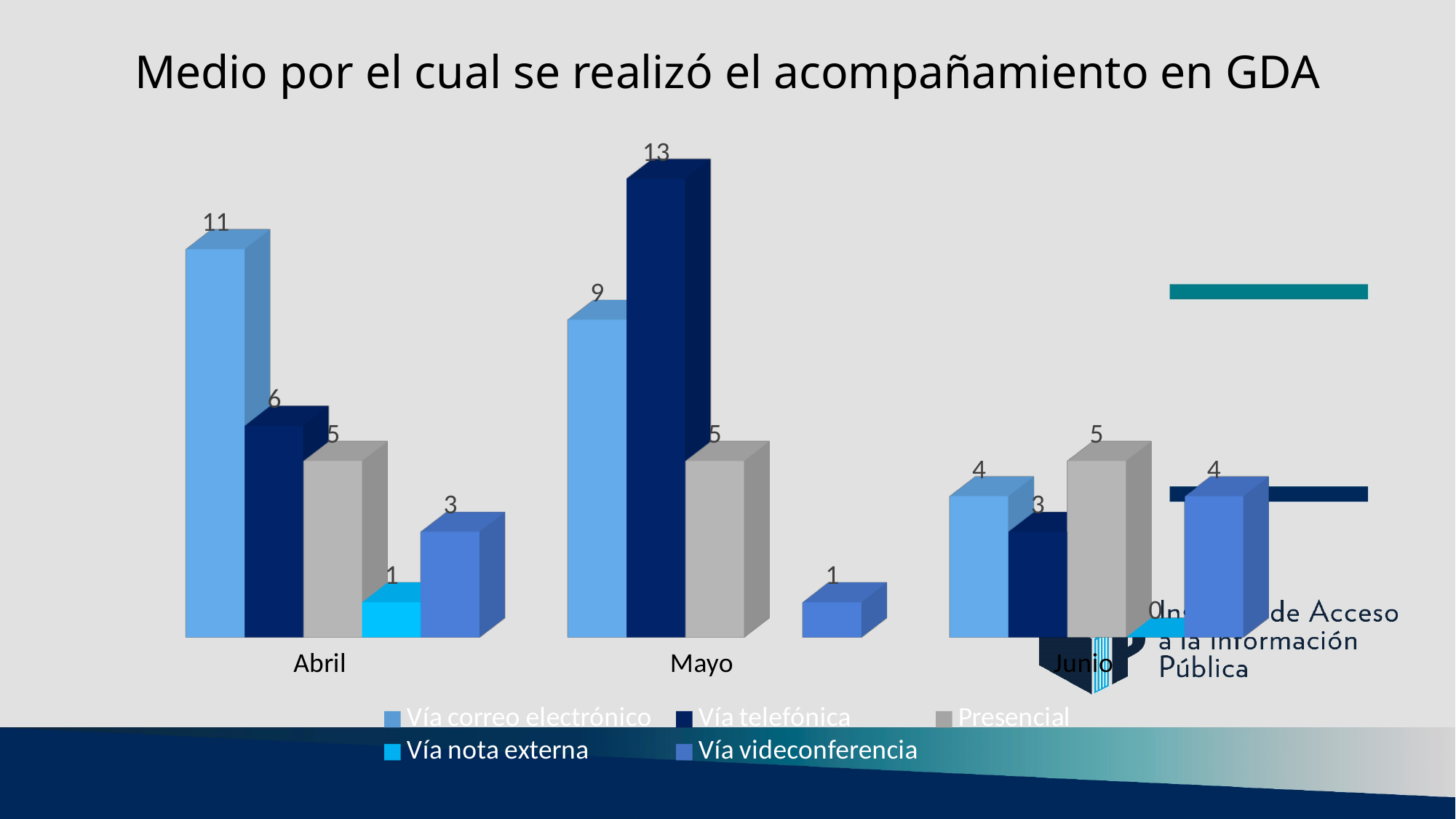
What is the value for Vía nota externa in Abril? 1 Which series has the lowest value in Junio? Vía nota externa What is the value for Vía videoconferencia in Junio? 4 How many series does the legend list? 5 What type of chart is shown on the slide? bar chart What is the value for Vía correo electrónico in Abril? 11 Which series has the highest value in Mayo? Vía telefónica Which is larger in Mayo: Vía correo electrónico or Presencial? Vía correo electrónico How many months are shown on the x axis? 3 What is the value for Vía telefónica in Mayo? 13 What is the value for Presencial in Junio? 5 What is the difference between Vía correo electrónico and Vía telefónica in Abril? 5